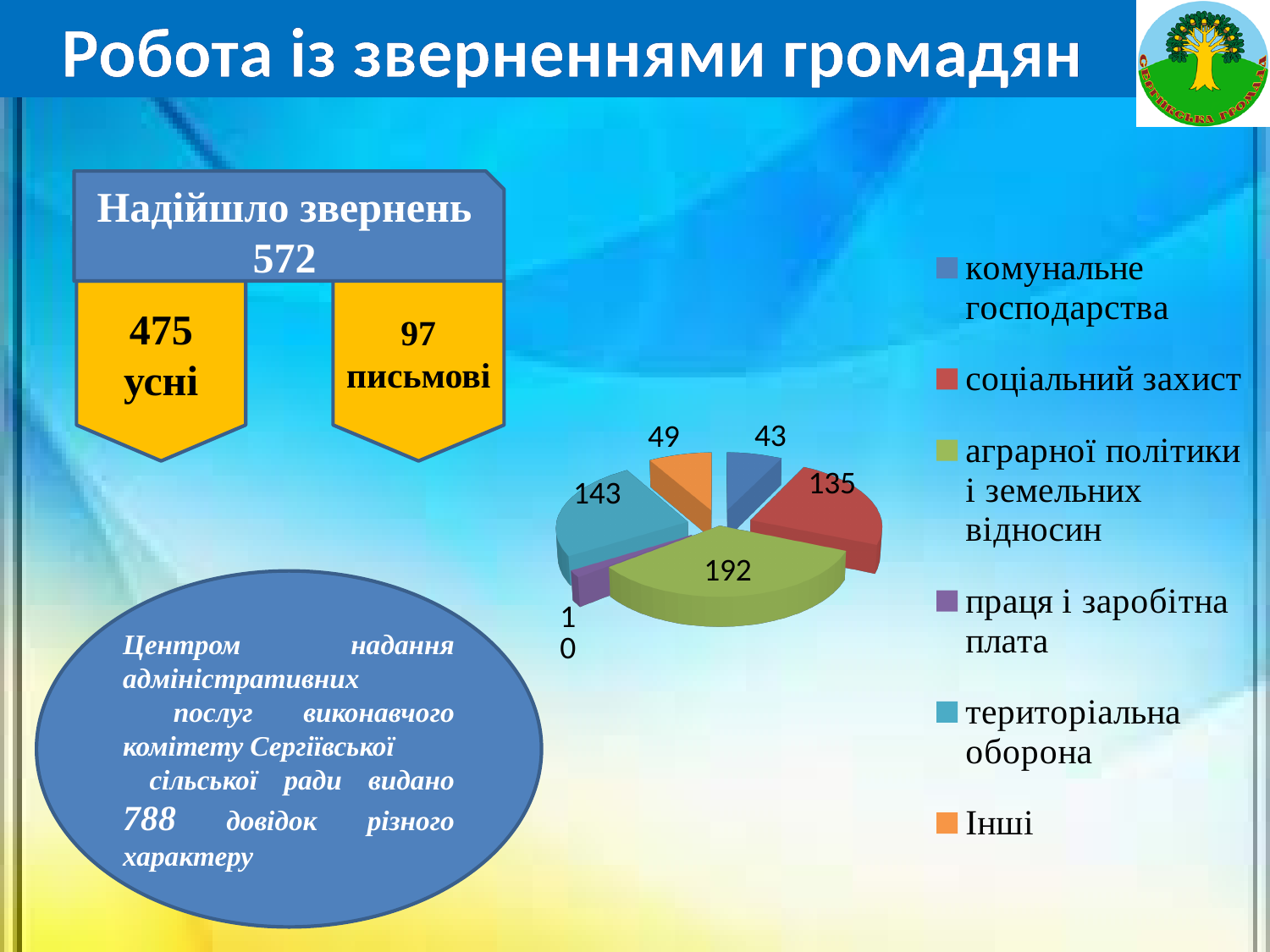
What is the value for комунальне господарства in the pie chart? 43 What share of the total 572 appeals does територіальна оборона (143) represent? 25% How many slices does the pie chart have? 6 What is the value for територіальна оборона in the pie chart? 143 What is the value for соціальний захист in the pie chart? 135 What is the value for Інші in the pie chart? 49 Which category has the smallest slice in the pie chart? праця і заробітна плата What kind of chart is shown on the slide? pie chart Which category has the largest slice in the pie chart? аграрної політики і земельних відносин What is the difference between the values for аграрної політики і земельних відносин and соціальний захист? 57 How many entries does the legend of the pie chart list? 6 Which is larger in the pie chart: територіальна оборона or соціальний захист? територіальна оборона